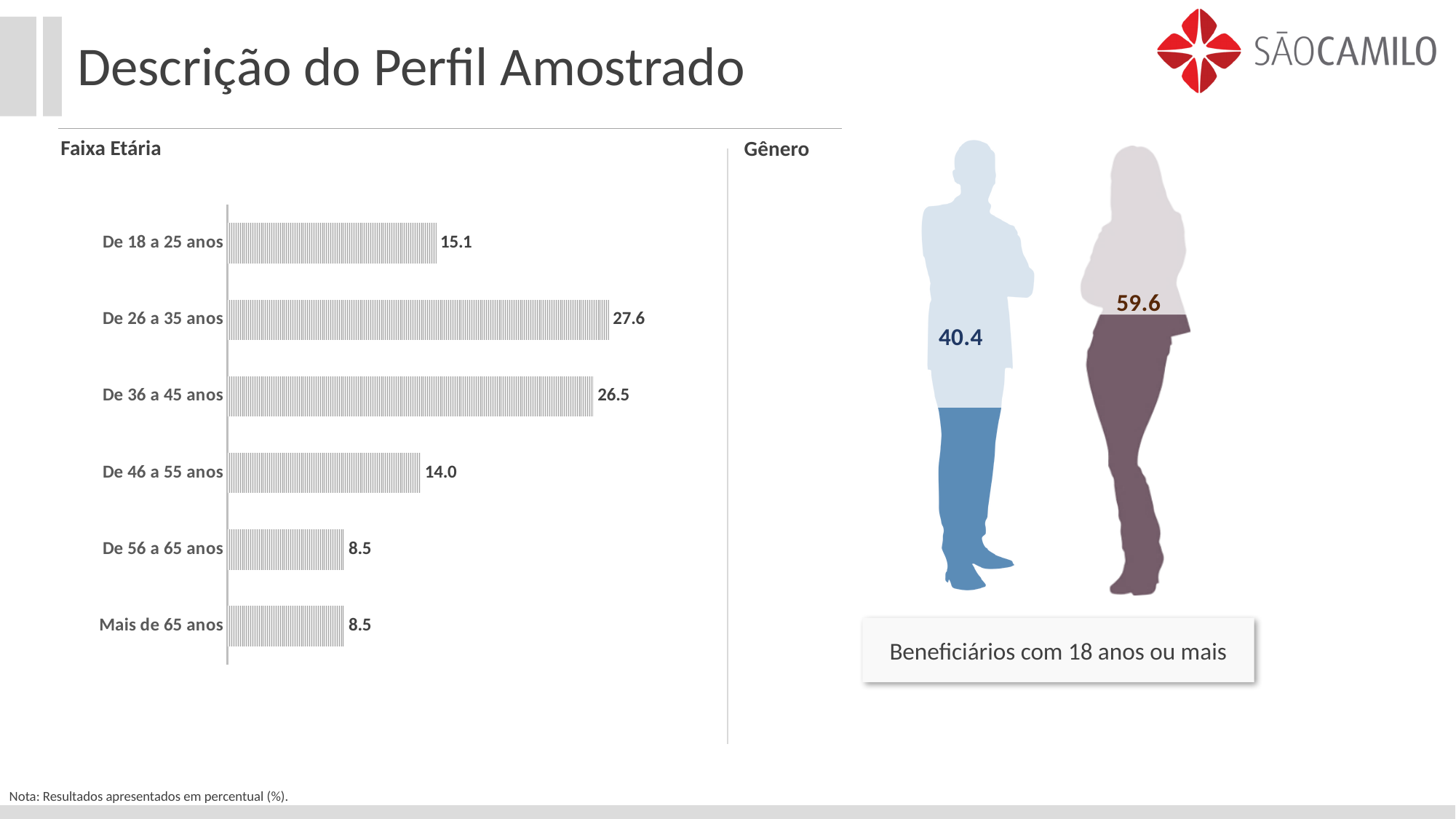
In the Faixa Etária chart, what is the difference between De 26 a 35 anos and De 36 a 45 anos? 1.1 What is the title of the bar chart on the left of the slide? Faixa Etária In the Faixa Etária chart, which is larger: De 18 a 25 anos or De 46 a 55 anos? De 18 a 25 anos What type of chart is the Faixa Etária chart? Bar chart In the Gênero graphic, what is the value shown for the female figure? 59.6 In the Faixa Etária chart, what is the value for De 18 a 25 anos? 15.1 In the Faixa Etária chart, what is the difference between De 18 a 25 anos and De 56 a 65 anos? 6.6 In the Faixa Etária chart, what is the value for Mais de 65 anos? 8.5 In the Faixa Etária chart, which age group has the highest value? De 26 a 35 anos In the Faixa Etária chart, what is the value for De 46 a 55 anos? 14.0 In the Gênero graphic, what is the difference between the female and male values? 19.2 How many age groups are shown in the Faixa Etária chart? 6